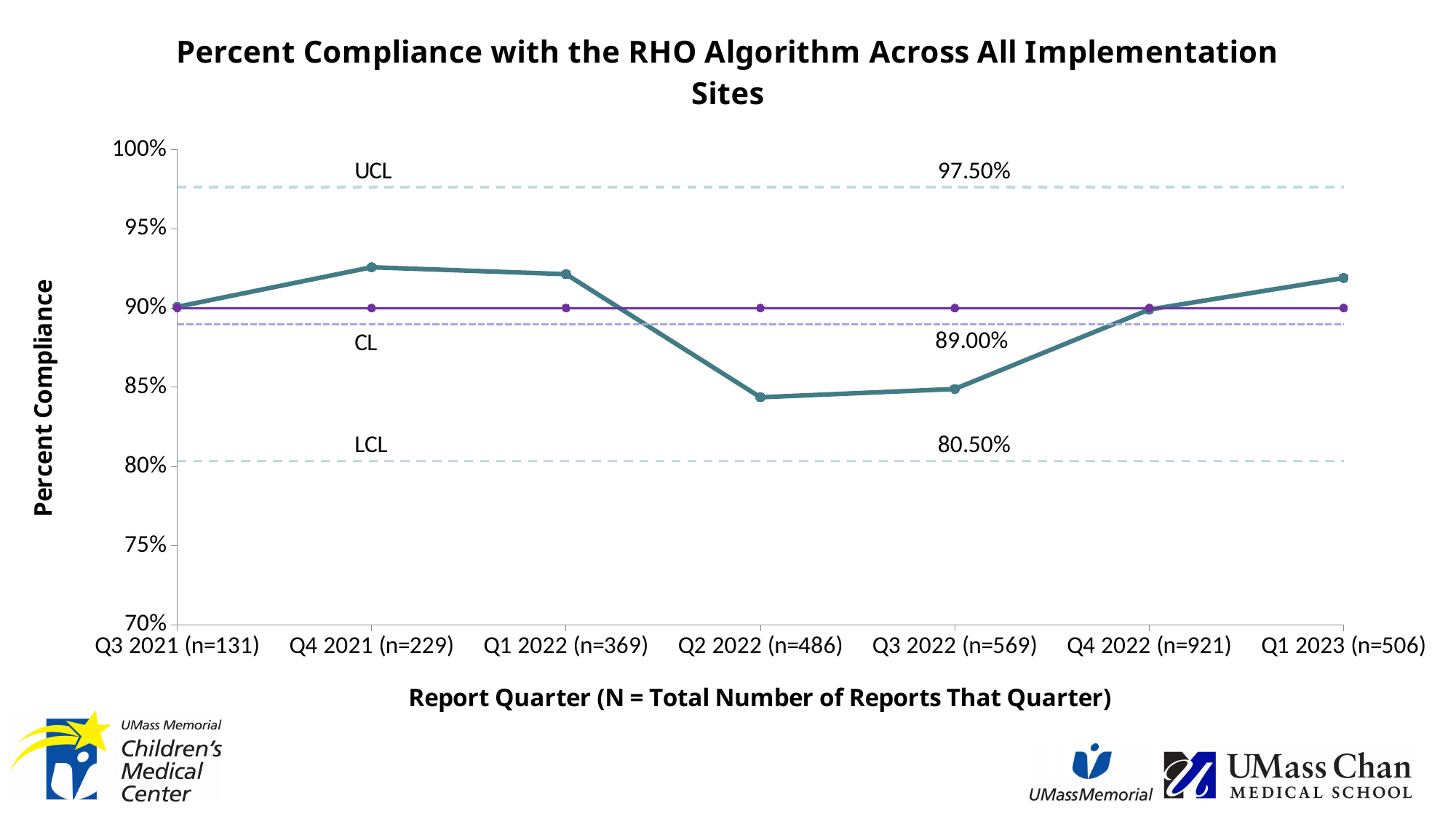
Does percent compliance rise or fall from Q1 2022 to Q2 2022? Fall What kind of chart is shown on the slide? Line chart Which has higher percent compliance, Q4 2021 (n=229) or Q2 2022 (n=486)? Q4 2021 (n=229) Is the percent compliance for Q4 2021 (n=229) greater or less than 90%? greater Is the percent compliance for Q2 2022 (n=486) greater or less than 85%? less What value is labelled for the CL line? 89.00% Does percent compliance rise or fall from Q3 2022 to Q1 2023? Rise How many report quarters are plotted on the x axis? 7 What is the title of the x axis? Report Quarter (N = Total Number of Reports That Quarter) What is the difference between the labelled UCL and LCL values? 17.00% What value is labelled for the UCL line? 97.50% What value is labelled for the LCL line? 80.50%